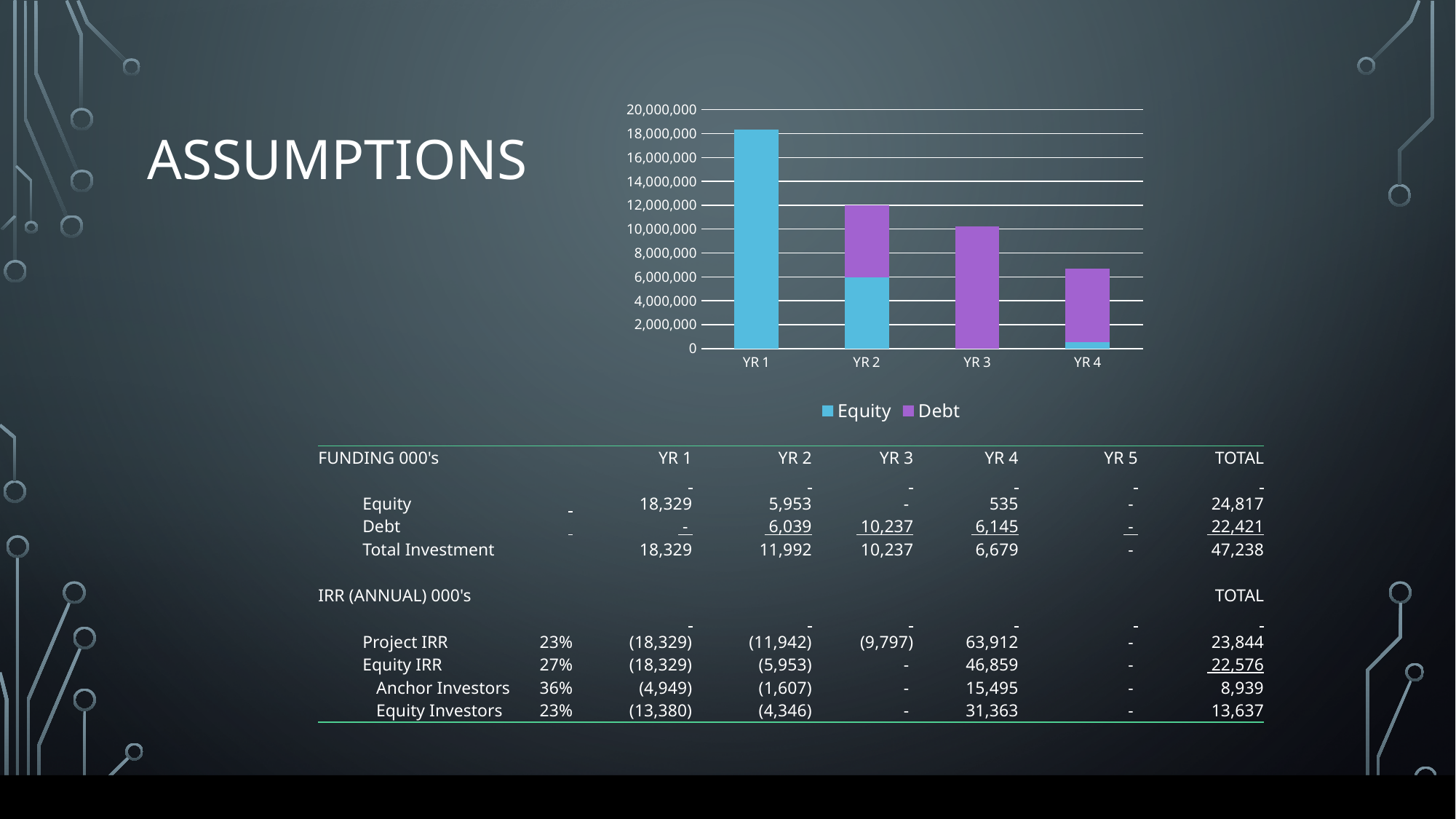
Which colour represents the Debt series in the chart? purple Is the Equity value for YR 4 greater or less than 2,000,000? less Which year has the shortest stacked bar in the chart? YR 4 Do the total bar heights rise or fall from YR 1 to YR 4? fall How many series does the chart legend list? 2 What kind of chart is shown on the slide? bar chart How many year categories are shown on the x axis of the chart? 4 Is the Debt value for YR 3 greater or less than 8,000,000? greater Is the total stacked bar for YR 4 greater or less than 8,000,000? less Which is larger, the Debt value for YR 3 or the Debt value for YR 4? YR 3 Which year has the tallest stacked bar in the chart? YR 1